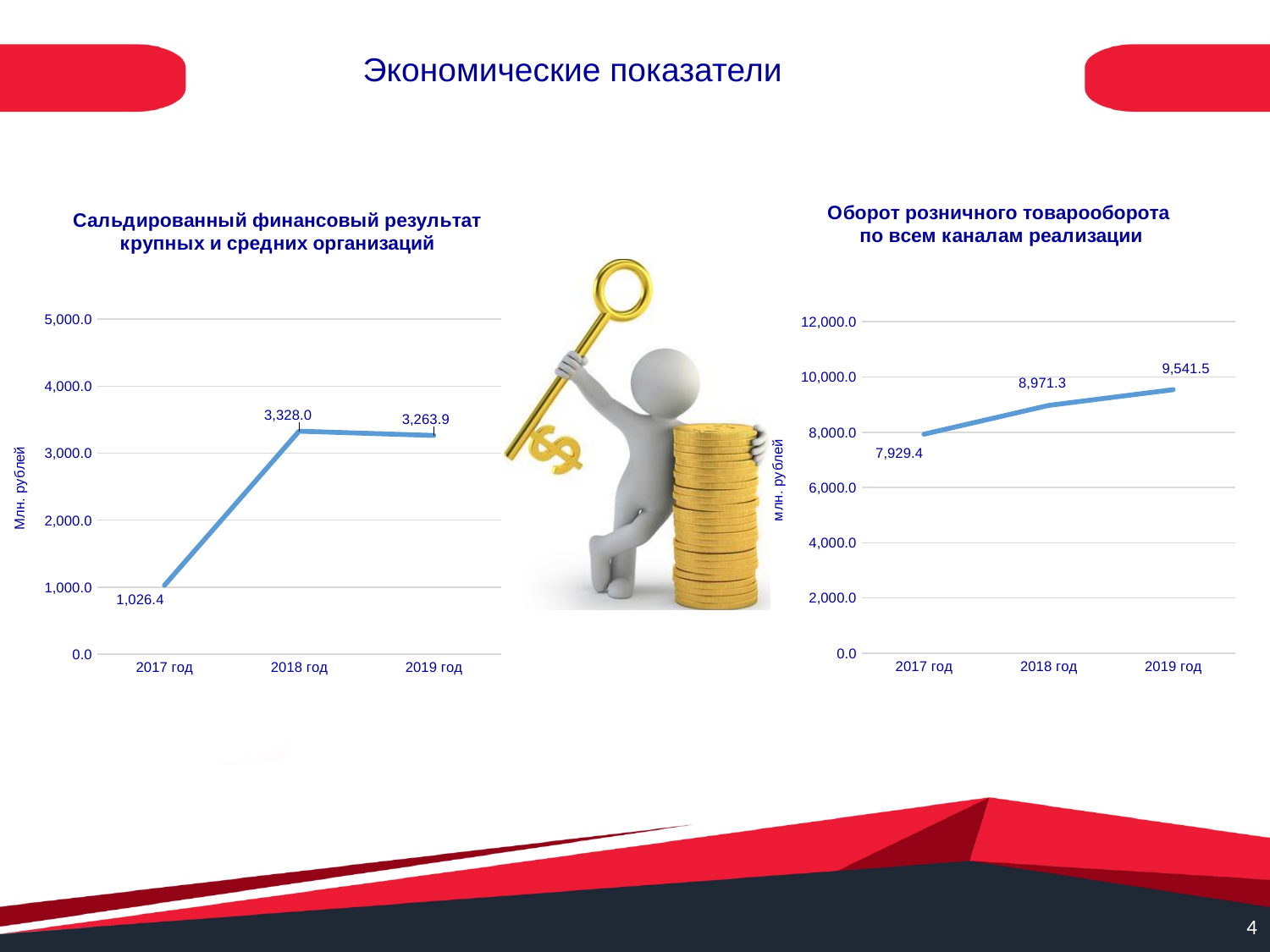
In the chart titled 'Сальдированный финансовый результат крупных и средних организаций', what is the value for 2018 год? 3,328.0 In the chart titled 'Оборот розничного товарооборота по всем каналам реализации', what is the value for 2017 год? 7,929.4 In the chart titled 'Сальдированный финансовый результат крупных и средних организаций', what is the value for 2017 год? 1,026.4 In the chart titled 'Сальдированный финансовый результат крупных и средних организаций', which year has the highest value? 2018 год In the chart titled 'Сальдированный финансовый результат крупных и средних организаций', what kind of chart is shown? Line chart In the chart titled 'Оборот розничного товарооборота по всем каналам реализации', what is the difference between the 2019 год and 2018 год values? 570.2 In the chart titled 'Оборот розничного товарооборота по всем каналам реализации', do the values rise or fall from 2017 год to 2019 год? Rise In the chart titled 'Оборот розничного товарооборота по всем каналам реализации', how many years are plotted? 3 In the chart titled 'Сальдированный финансовый результат крупных и средних организаций', what is the difference between the 2018 год and 2017 год values? 2,301.6 In the chart titled 'Оборот розничного товарооборота по всем каналам реализации', what is the label of the vertical axis? млн. рублей In the chart titled 'Оборот розничного товарооборота по всем каналам реализации', what is the value for 2019 год? 9,541.5 In the chart titled 'Сальдированный финансовый результат крупных и средних организаций', which year has the lowest value? 2017 год